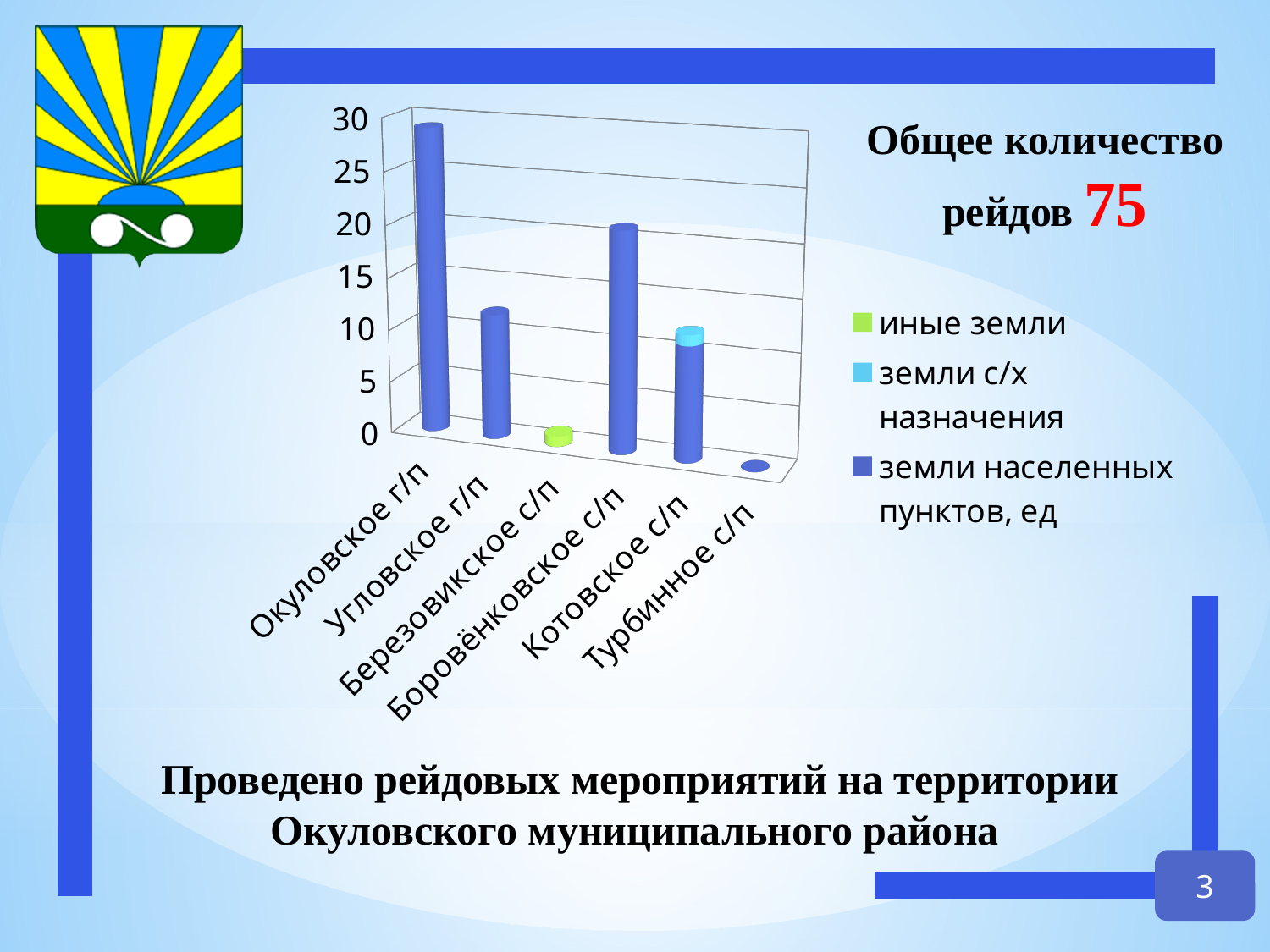
Is the value for Угловское г/п greater or less than 15? less How many categories are shown along the x axis of the chart? 6 Is the value for Боровёнковское с/п greater or less than 15? greater How many series does the chart legend list? 3 What kind of chart is shown on the slide? bar chart Which category is the only one with a bar for the series 'земли с/х назначения'? Котовское с/п Which category has the highest bar in the chart? Окуловское г/п Which is larger, the bar for Боровёнковское с/п or the bar for Угловское г/п? Боровёнковское с/п Is the value for Окуловское г/п greater or less than 25? greater Which legend entry is shown in green? иные земли Which is larger, the bar for Окуловское г/п or the bar for Угловское г/п? Окуловское г/п